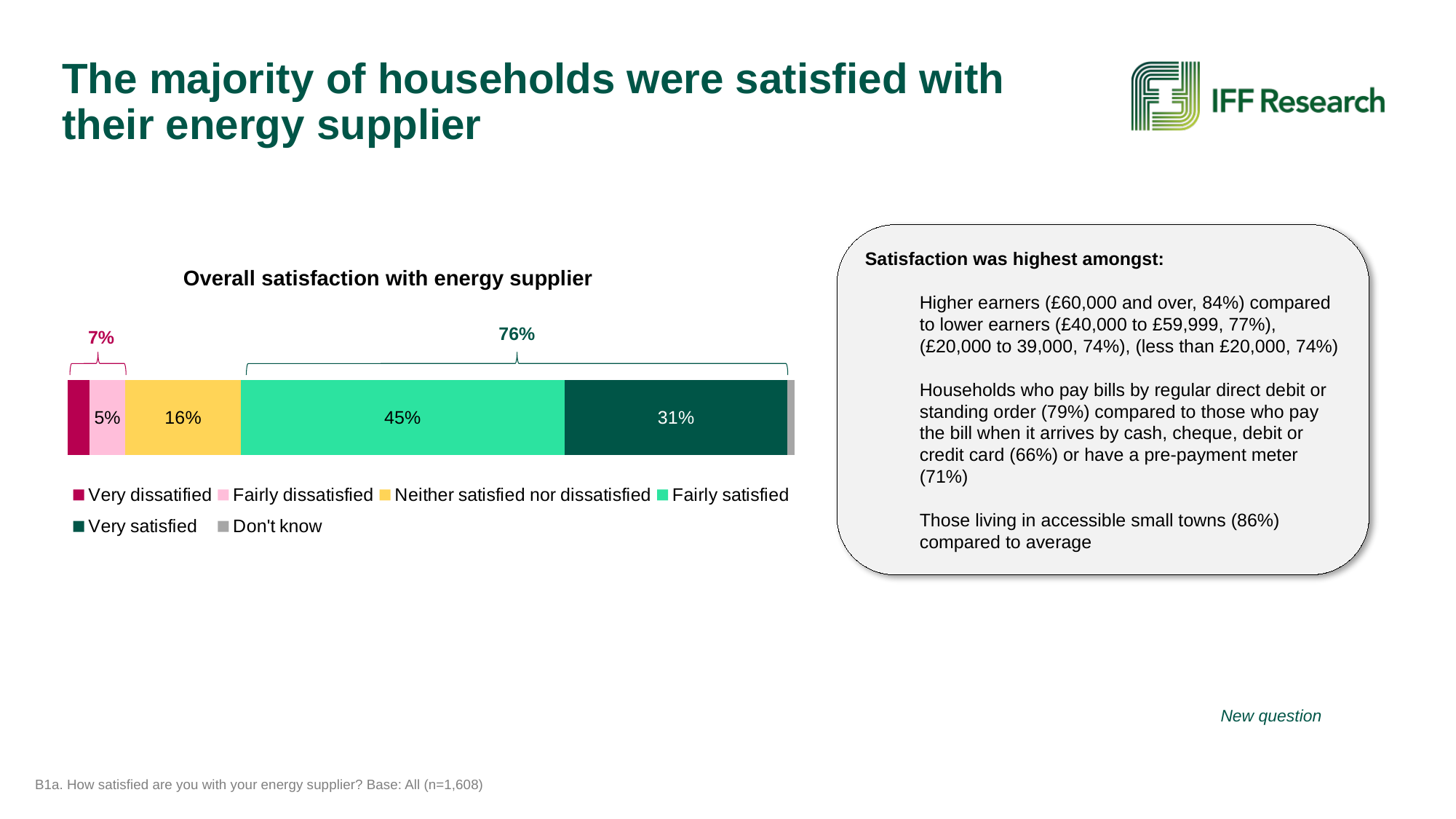
How many response categories does the legend list? 6 What combined percentage is shown above the bar for the satisfied categories (fairly satisfied plus very satisfied)? 76% Which response category has the largest share of the bar? Fairly satisfied Which is larger: the share for fairly satisfied or the share for very satisfied? Fairly satisfied What percentage of households were fairly satisfied with their energy supplier? 45% What percentage of households were very satisfied with their energy supplier? 31% What is the difference in percentage points between fairly satisfied and very satisfied? 14 percentage points What type of chart is used to show overall satisfaction with energy supplier? Stacked bar chart What combined percentage is shown above the bar for the dissatisfied categories? 7% What is the difference in percentage points between neither satisfied nor dissatisfied and fairly dissatisfied? 11 percentage points What percentage of households were neither satisfied nor dissatisfied? 16% What percentage of households were fairly dissatisfied? 5%